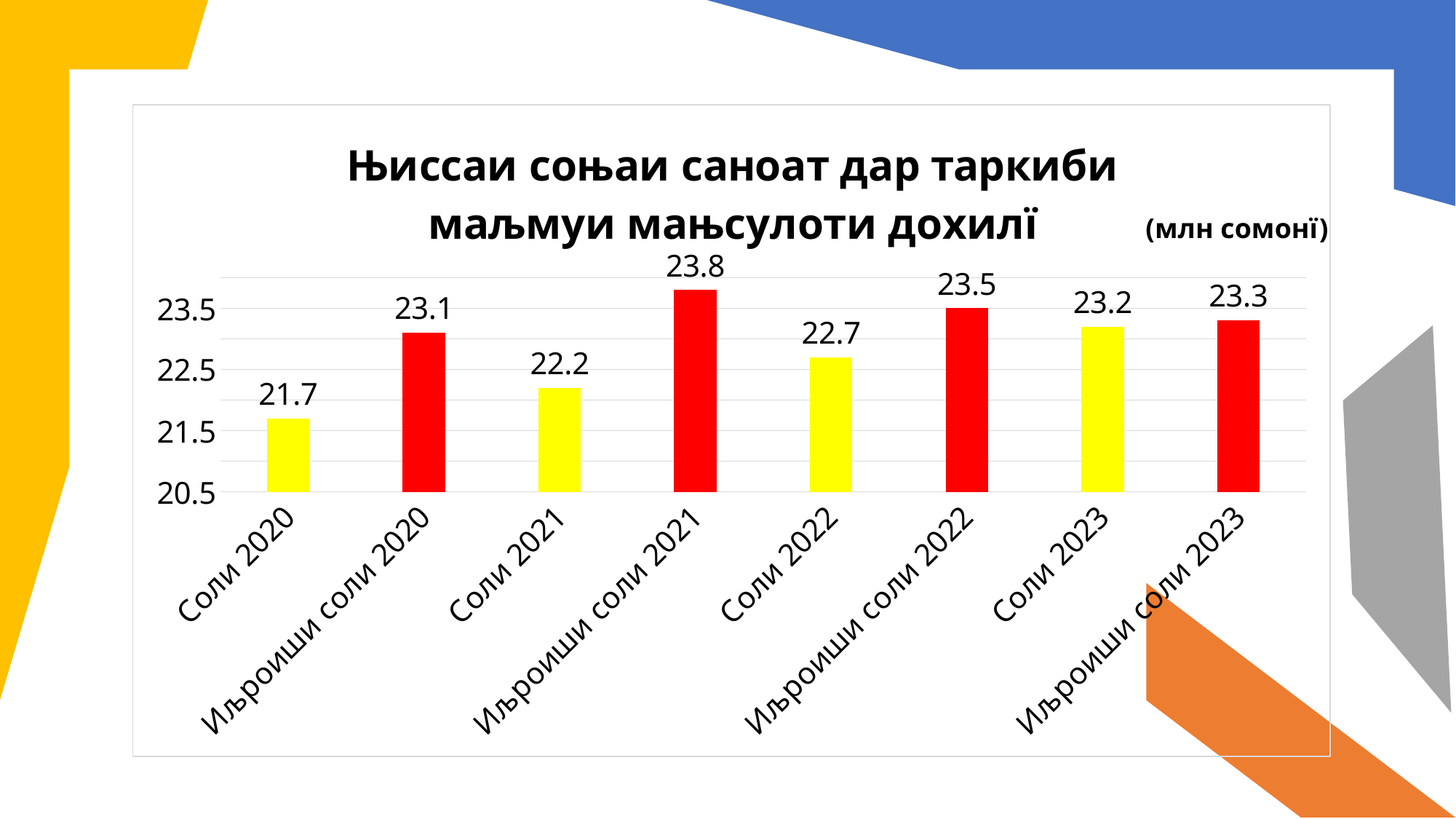
What is the difference between Иљроиши соли 2020 and Соли 2020? 1.4 Which is larger, the value for Соли 2022 or the value for Иљроиши соли 2022? Иљроиши соли 2022 What is the value for Иљроиши соли 2021? 23.8 What is the difference between Иљроиши соли 2022 and Соли 2022? 0.8 Is the value for Соли 2021 greater or less than 22.5? less What kind of chart is shown on the slide? bar chart Which category has the lowest value? Соли 2020 How many bars are shown in the chart? 8 Which category has the highest value? Иљроиши соли 2021 What is the value for Соли 2020? 21.7 What is the value for Соли 2023? 23.2 What unit is given in parentheses next to the chart title? млн сомонї